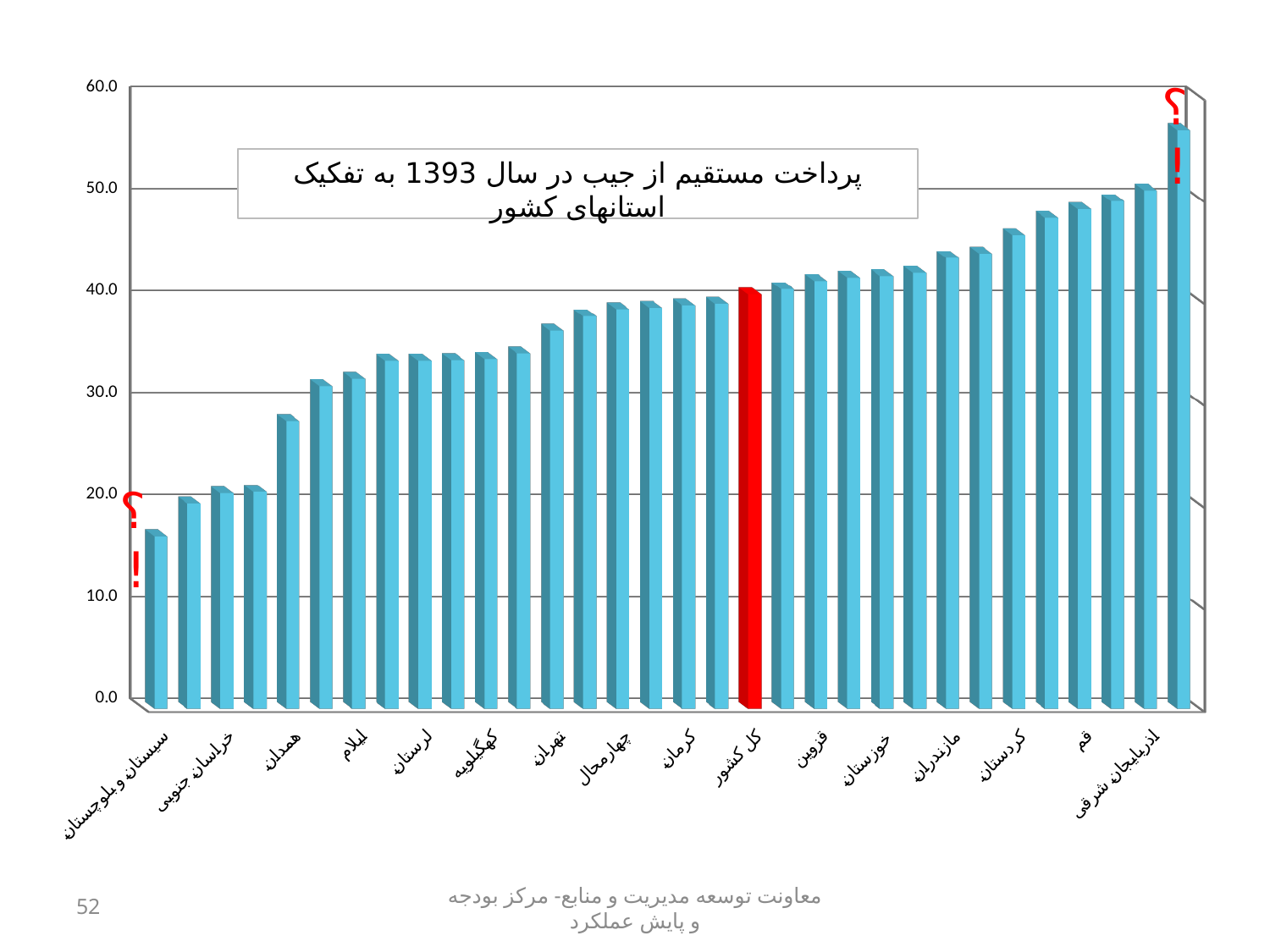
Is the value for سیستان و بلوچستان greater or less than 20.0? less Is the value for تهران greater or less than 40.0? less Which is larger, the value for تهران or the value for کردستان? کردستان What kind of chart is shown on the slide? bar chart Do the bar values rise or fall from left to right along the x axis? rise Which category is drawn with a red bar instead of a blue one? کل کشور What is the title of the chart? پرداخت مستقیم از جیب در سال 1393 به تفکیک استانهای کشور Which labelled province has the highest bar? آذربایجان شرقی Is the value for کردستان greater or less than 40.0? greater Which labelled province has the lowest bar? سیستان و بلوچستان